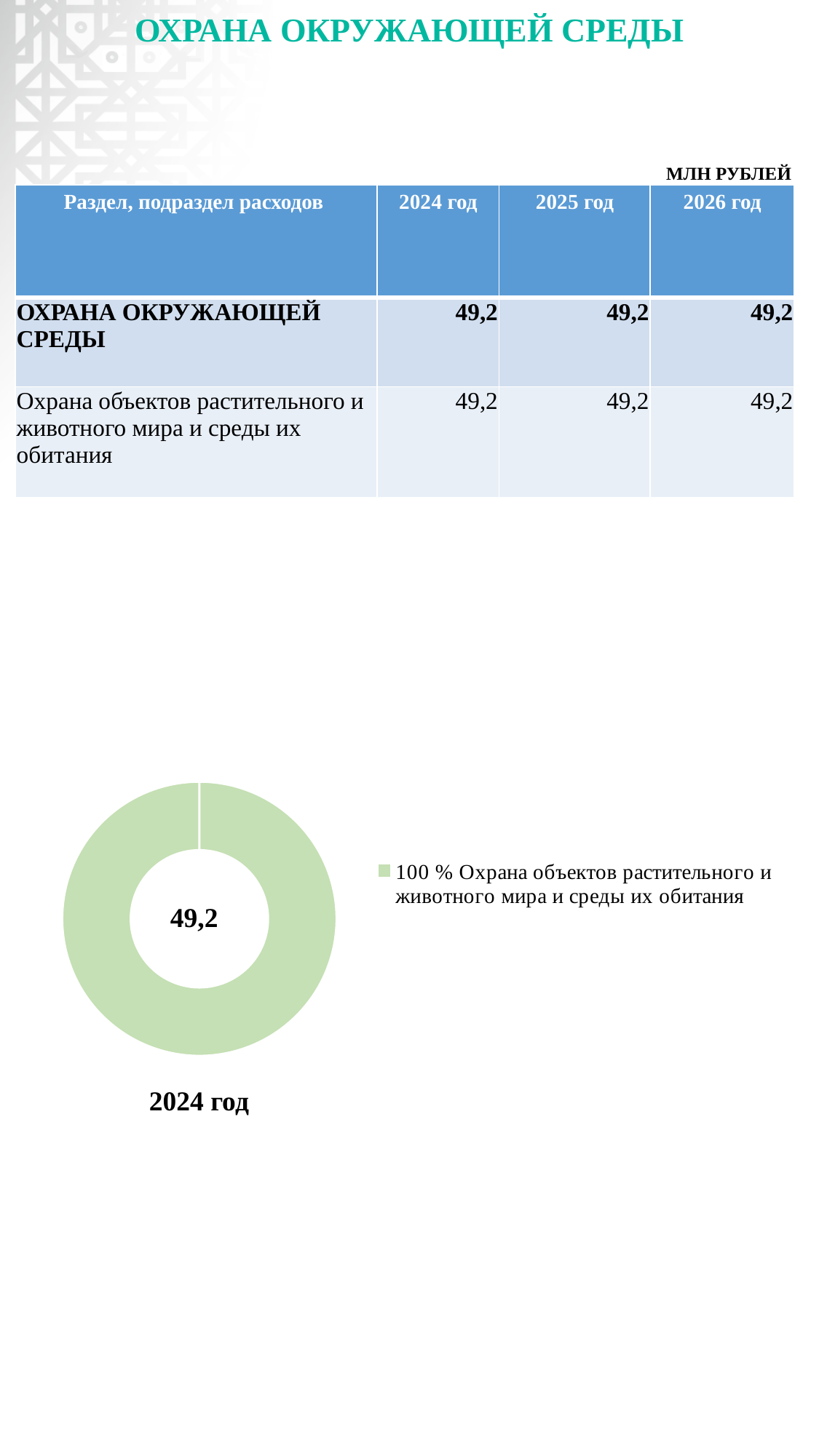
Which year is the doughnut chart labelled with? 2024 год What value is printed in the centre of the doughnut chart? 49,2 How many entries does the legend of the doughnut chart list? 1 What share of the doughnut chart does "Охрана объектов растительного и животного мира и среды их обитания" take? 100 % What colour is the slice in the doughnut chart? Light green What kind of chart is shown at the bottom of the slide? Doughnut chart How many slices does the doughnut chart have? 1